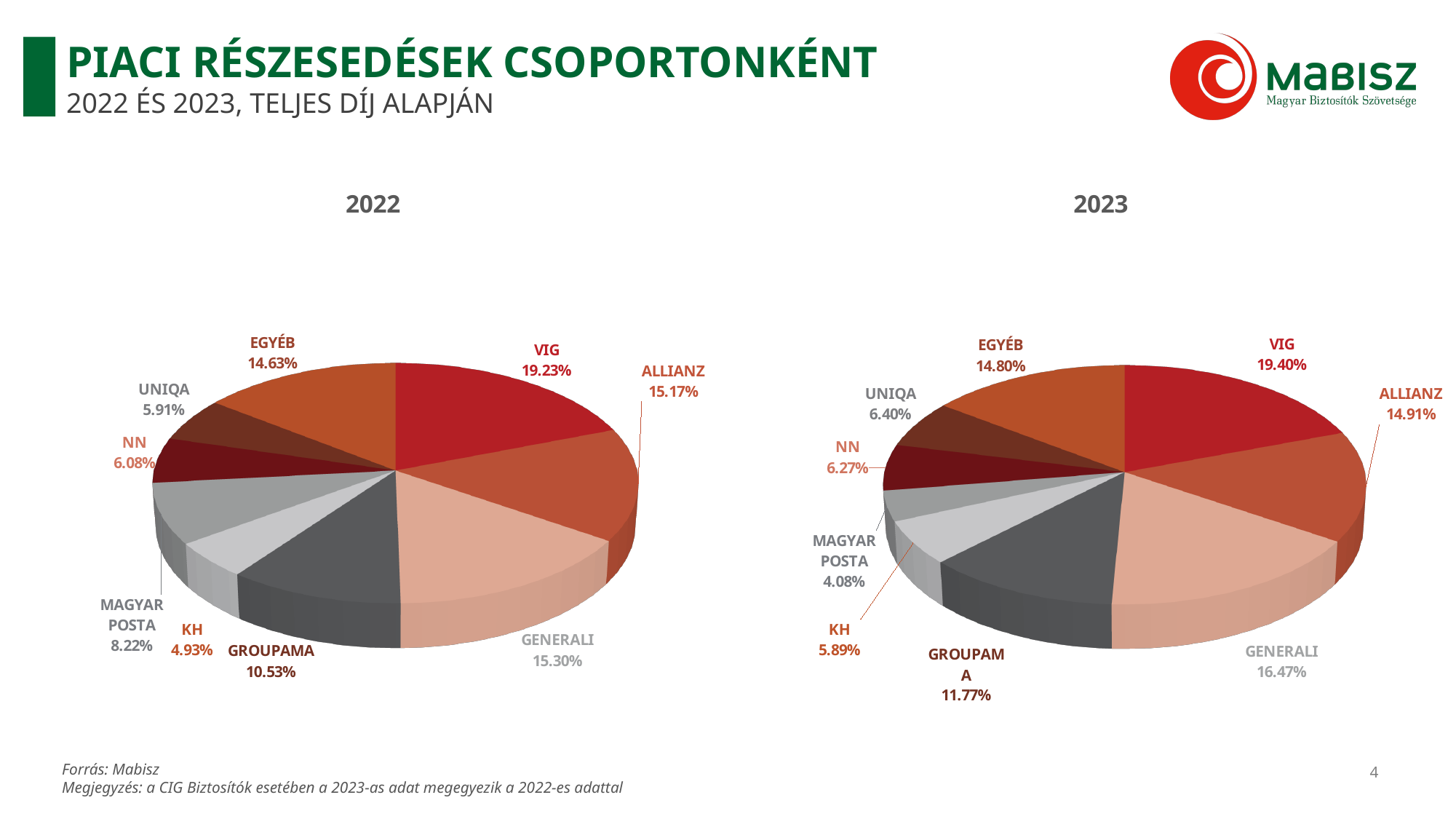
In the 2023 pie chart, which group has the smallest share? MAGYAR POSTA What is the title of the chart on the right side of the slide? 2023 In the 2022 pie chart, what is the difference between the shares of GENERALI and GROUPAMA? 4.77% In the 2023 pie chart, what is the difference between the shares of VIG and ALLIANZ? 4.49% In the 2022 pie chart, which is larger, the share of ALLIANZ or the share of GENERALI? GENERALI In the 2022 pie chart, which group has the smallest share? KH In the 2023 pie chart, what is the share for MAGYAR POSTA? 4.08% In the 2022 pie chart, which group has the largest share? VIG What type of chart is used to show the 2022 market shares? Pie chart In the 2023 pie chart, what is the share for GENERALI? 16.47% In the 2022 pie chart, what is the share for VIG? 19.23% How many groups are shown in the 2023 pie chart? 9